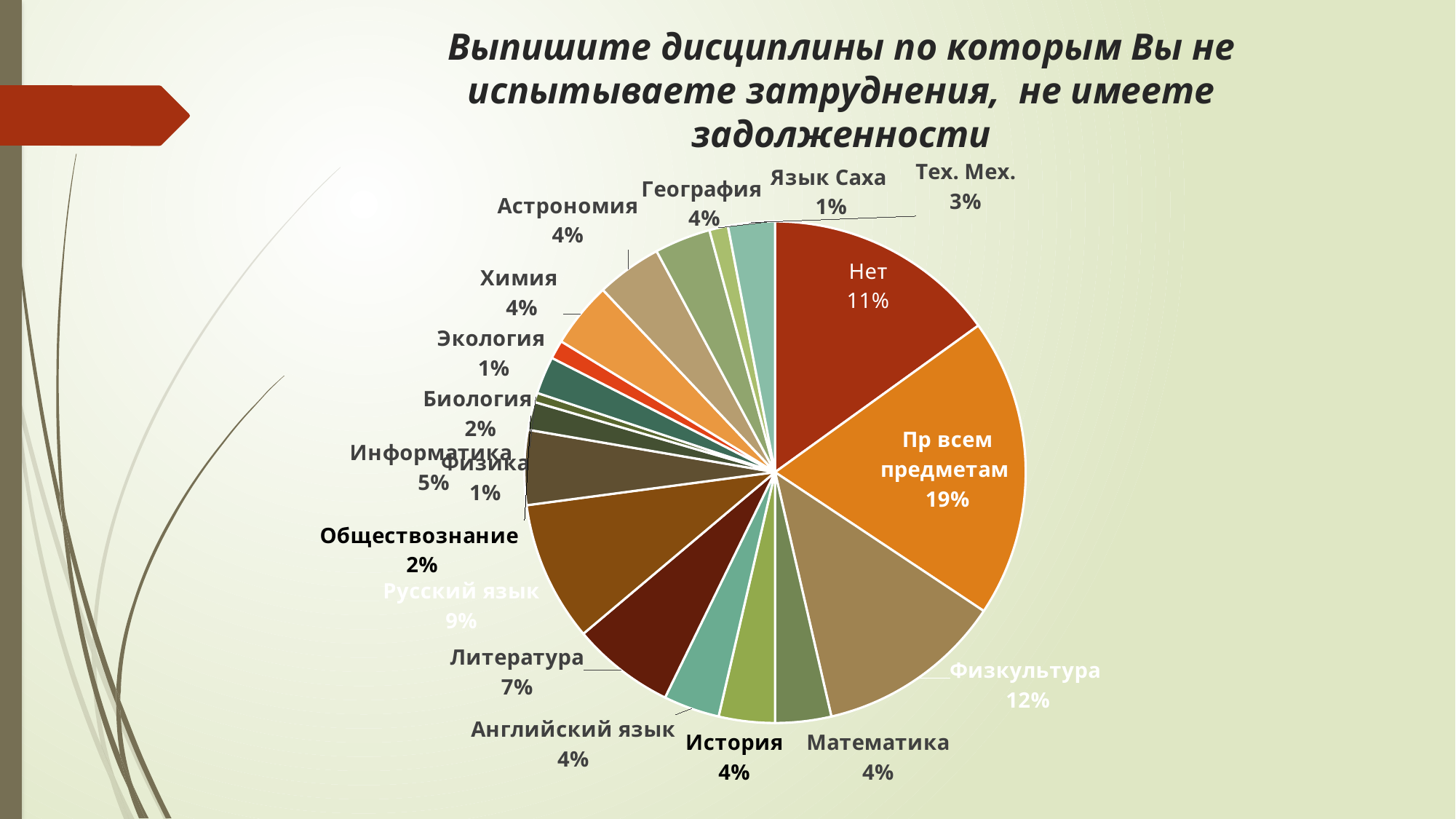
What kind of chart is shown on the slide? Pie chart What is the value shown for "Литература"? 7% Which category has the largest slice of the pie? Пр всем предметам Which is larger, the value for "Физкультура" or the value for "Русский язык"? Физкультура How many categories are shown in the pie chart? 18 What is the difference between the values for "Пр всем предметам" and "Нет"? 8% What share of the pie does "Пр всем предметам" represent? 19% What is the value shown for "Физкультура"? 12% What is the value shown for "Тех. Мех."? 3% What is the value shown for "Экология"? 1% What is the value shown for "Русский язык"? 9% What is the value shown for "Информатика"? 5%